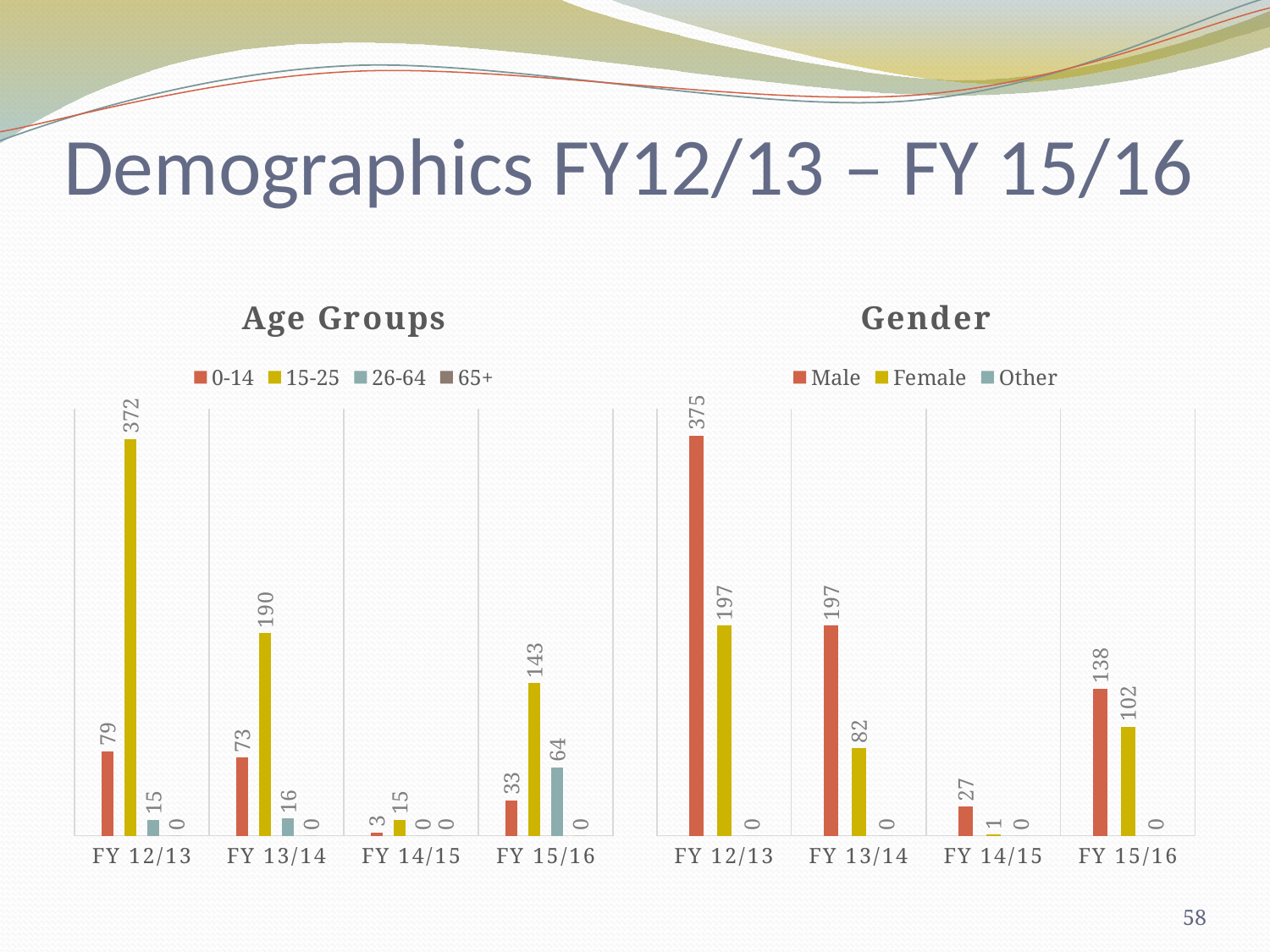
In the Gender chart, what is the value for Female in FY 15/16? 102 In the Age Groups chart, which fiscal year has the highest value for 0-14? FY 12/13 What kind of chart is the Gender chart? Bar chart In the Age Groups chart, what is the value for 15-25 in FY 12/13? 372 How many series does the legend of the Age Groups chart list? 4 In the Gender chart, which is larger in FY 13/14, Male or Female? Male In the Gender chart, what is the difference between Male and Female in FY 12/13? 178 In the Gender chart, what is the value for Male in FY 12/13? 375 In the Age Groups chart, what is the difference between the 15-25 values for FY 12/13 and FY 13/14? 182 How many fiscal years are shown on the x axis of the Gender chart? 4 In the Age Groups chart, what is the value for 26-64 in FY 15/16? 64 In the Age Groups chart, which fiscal year has the lowest value for 15-25? FY 14/15